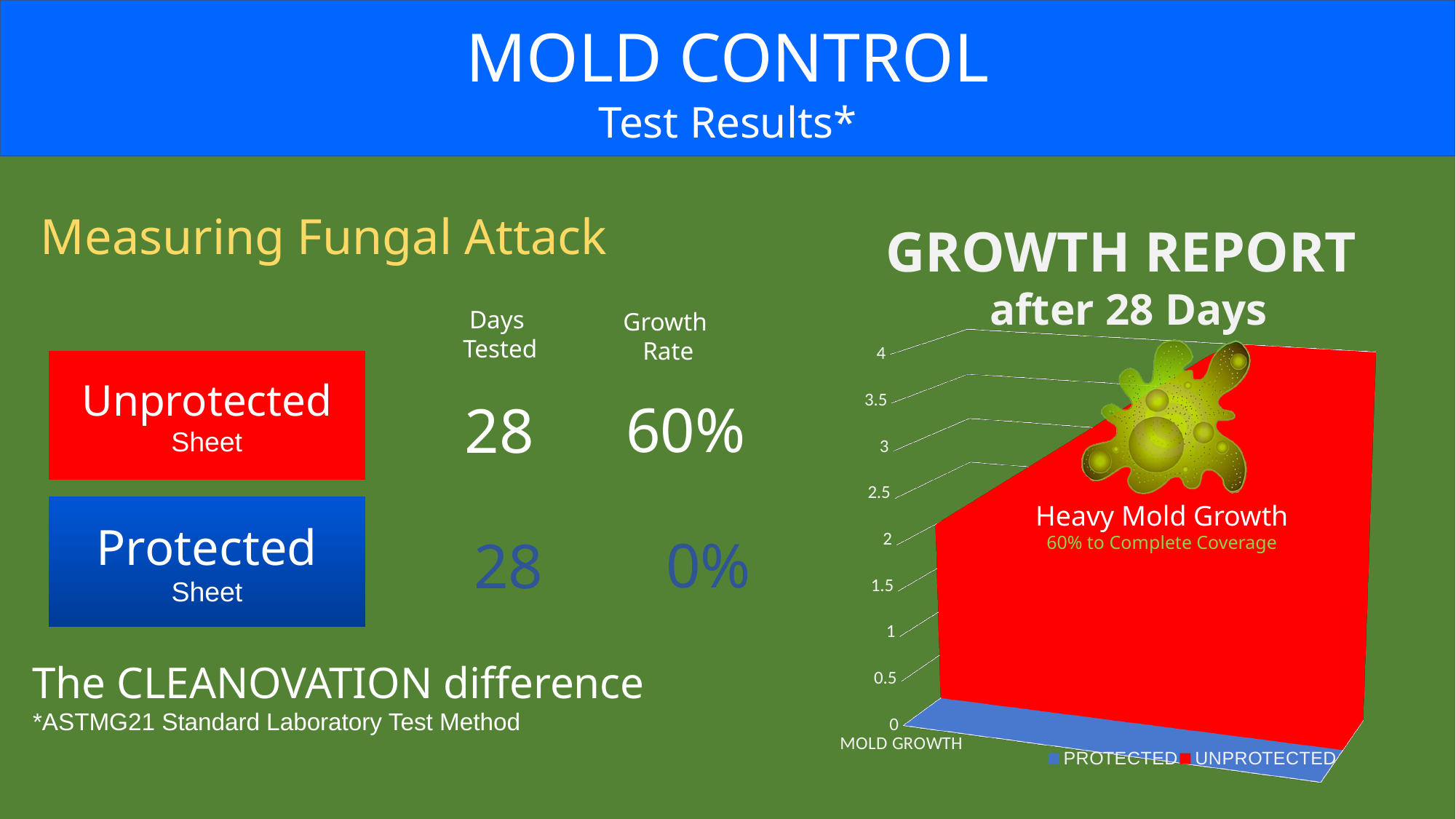
In the GROWTH REPORT chart, is the value for UNPROTECTED greater or less than 1? greater In the GROWTH REPORT chart, which series has the highest value? UNPROTECTED What is the category label on the horizontal axis of the GROWTH REPORT chart? MOLD GROWTH What is the highest value shown on the vertical axis of the GROWTH REPORT chart? 4 What are the two series named in the legend of the GROWTH REPORT chart? PROTECTED and UNPROTECTED How many categories are shown on the horizontal axis of the GROWTH REPORT chart? 1 In the GROWTH REPORT chart, which series is larger, PROTECTED or UNPROTECTED? UNPROTECTED How many series does the legend of the GROWTH REPORT chart list? 2 In the GROWTH REPORT chart, which series has the lowest value? PROTECTED What is the title of the chart on the right side of the slide? GROWTH REPORT after 28 Days In the GROWTH REPORT chart, is the value for PROTECTED greater or less than 0.5? less